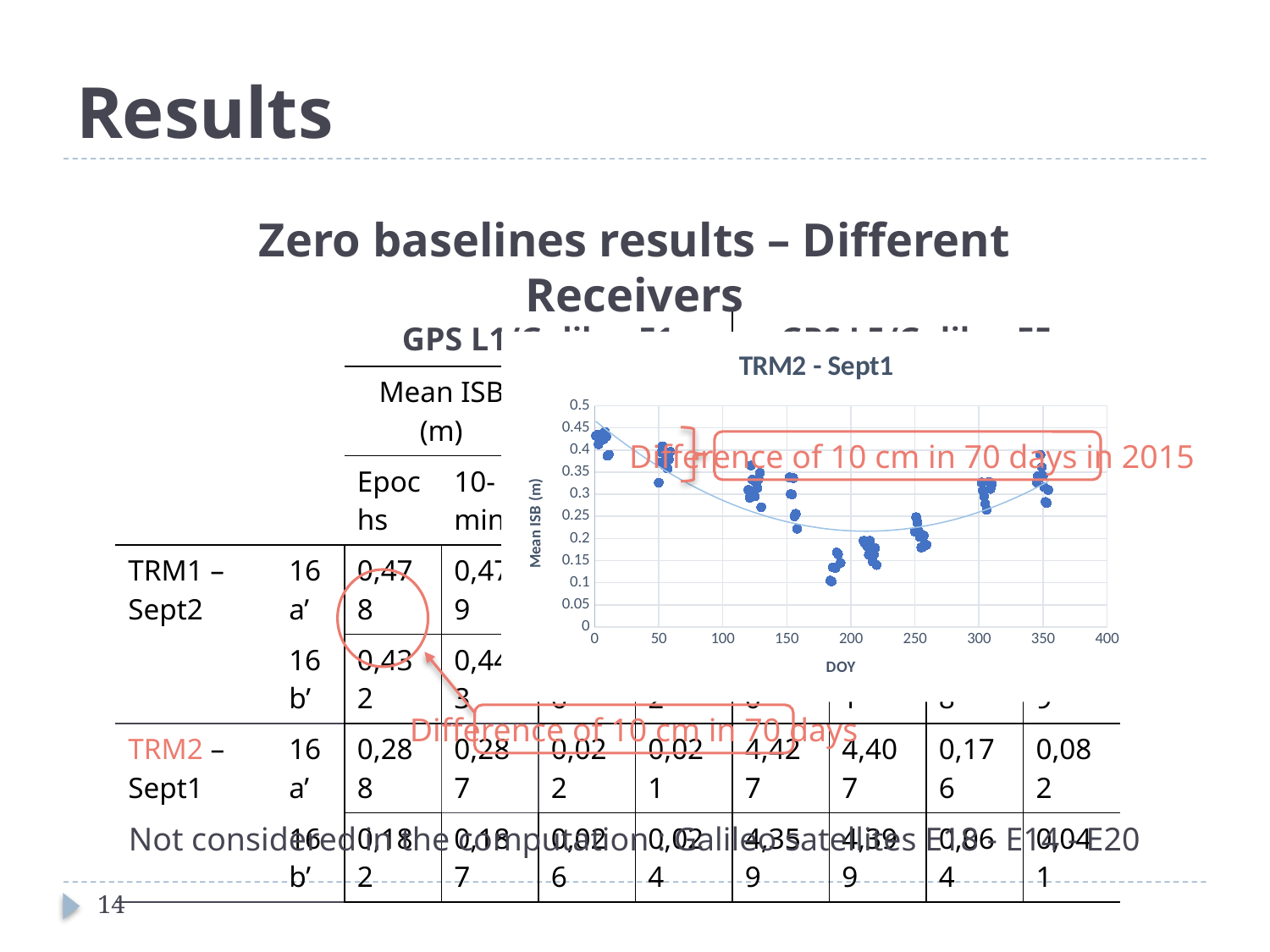
In the TRM2 - Sept1 chart, do the Mean ISB values rise or fall between DOY 200 and DOY 350? rise What kind of chart is shown on the slide? scatter chart What is the maximum value shown on the y axis of the TRM2 - Sept1 chart? 0.5 In the TRM2 - Sept1 chart, do the Mean ISB values rise or fall between DOY 0 and DOY 200? fall In the TRM2 - Sept1 chart, around which DOY region do the lowest Mean ISB values occur: near DOY 50 or near DOY 190? near DOY 190 What is the title of the chart on the slide? TRM2 - Sept1 In the TRM2 - Sept1 chart, are the values for the points near DOY 50 greater or less than 0.45? less In the TRM2 - Sept1 chart, are the values for the points near DOY 190 greater or less than 0.2? less In the TRM2 - Sept1 chart, are the values for the points near DOY 5 greater or less than 0.35? greater In the TRM2 - Sept1 chart, which group of points has higher Mean ISB values: those near DOY 5 or those near DOY 200? those near DOY 5 What is the label of the x axis of the TRM2 - Sept1 chart? DOY